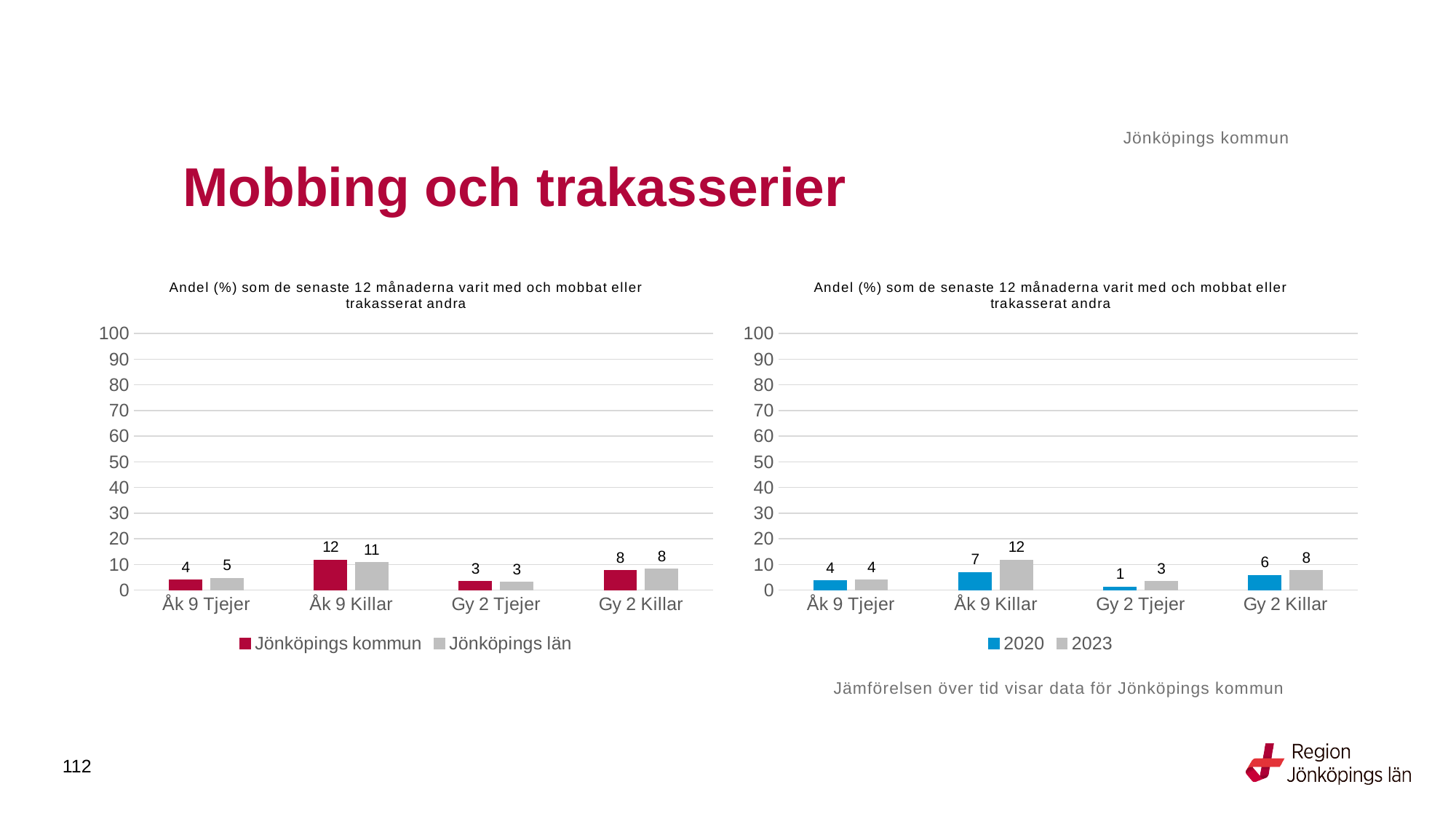
In the left chart, what is the value for Jönköpings kommun for Åk 9 Killar? 12 In the right chart, is the 2023 value for Gy 2 Killar greater or less than 20? less In the left chart, what is the value for Jönköpings län for Åk 9 Tjejer? 5 In the left chart, which is larger for Åk 9 Killar: Jönköpings kommun or Jönköpings län? Jönköpings kommun What kind of chart is the left chart? Bar chart In the right chart, which category has the lowest value for 2020? Gy 2 Tjejer In the right chart, what is the value for 2023 for Åk 9 Killar? 12 In the left chart, which category has the highest value for Jönköpings kommun? Åk 9 Killar In the right chart, what is the value for 2020 for Gy 2 Tjejer? 1 In the right chart, what is the difference between the 2023 and 2020 values for Åk 9 Killar? 5 How many series does the legend of the right chart list? 2 How many categories are shown on the x axis of the left chart? 4